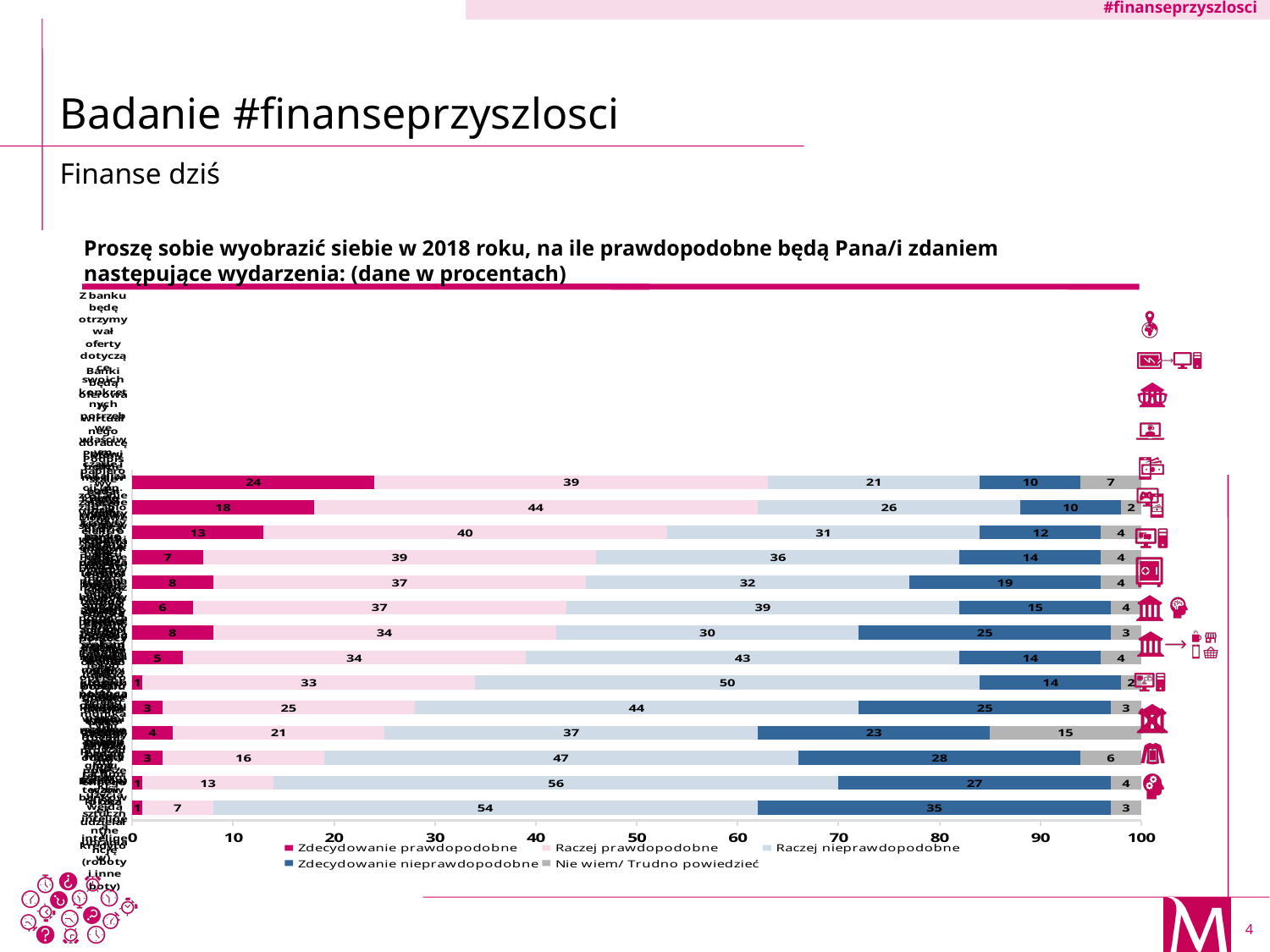
What is the highest 'Zdecydowanie nieprawdopodobne' value shown in the chart? 35 What is the value of 'Zdecydowanie prawdopodobne' for the topmost bar? 24 How many bars (categories) are plotted in the chart? 14 How many series does the chart legend list? 5 What is the value of 'Nie wiem/ Trudno powiedzieć' for the fourth bar from the bottom? 15 In the topmost bar, what is the difference between 'Raczej prawdopodobne' (39) and 'Zdecydowanie prawdopodobne' (24)? 15 Which bar has the highest 'Zdecydowanie prawdopodobne' value, and what is it? The topmost bar, 24 In the bottom bar, which is larger: 'Raczej nieprawdopodobne' or 'Zdecydowanie nieprawdopodobne'? Raczej nieprawdopodobne Which legend entry is shown in grey? Nie wiem/ Trudno powiedzieć What kind of chart is shown on the slide? Stacked bar chart What is the total of the second bar from the top (18, 44, 26, 10, 2)? 100 What is the value of 'Raczej nieprawdopodobne' for the bottom bar? 54